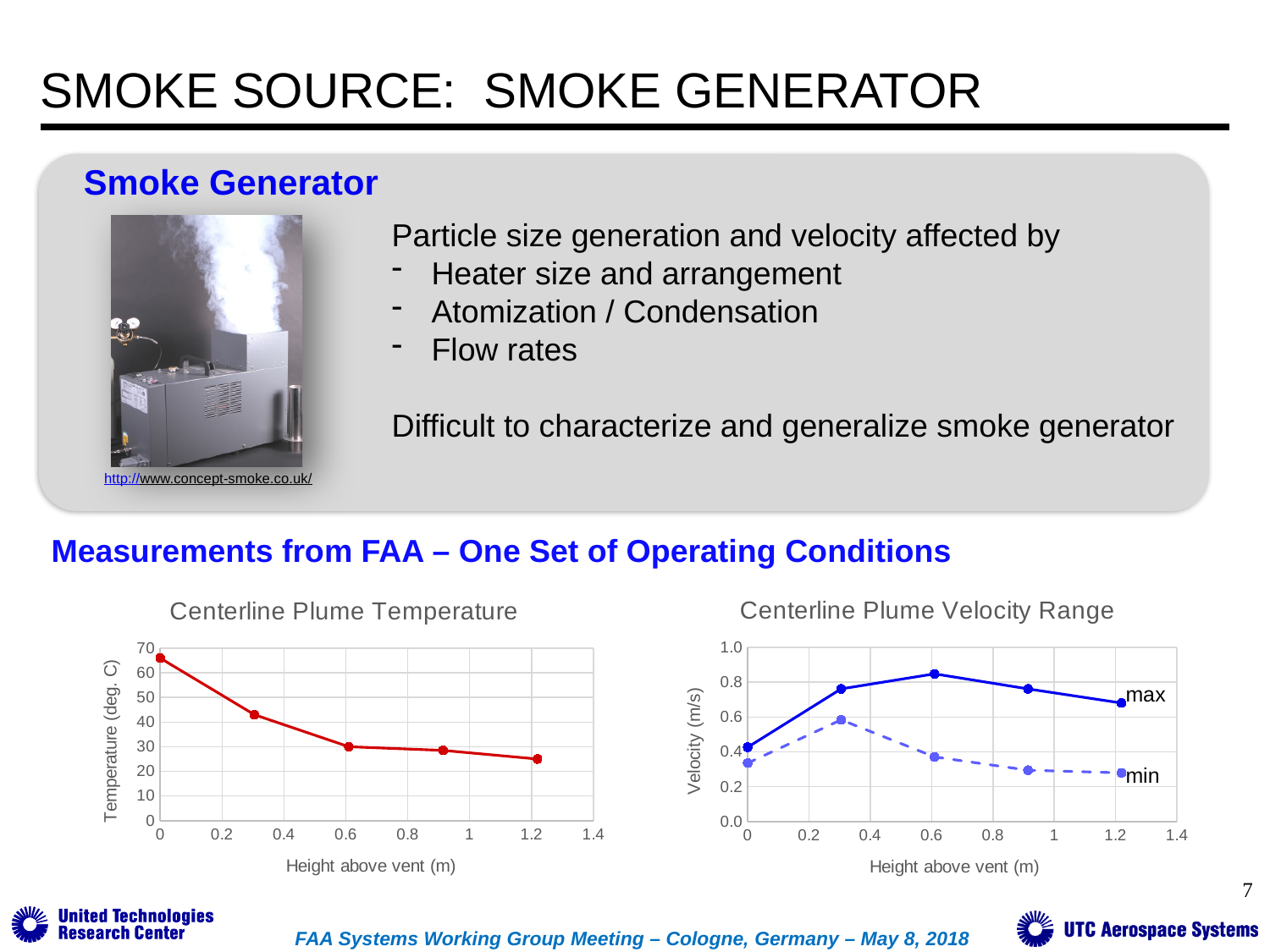
In the Centerline Plume Velocity Range chart, is the max velocity at height 0.6 m greater or less than 0.8? greater In the Centerline Plume Temperature chart, what is the label of the y axis? Temperature (deg. C) In the Centerline Plume Temperature chart, at which height above vent is the temperature highest? 0 In the Centerline Plume Temperature chart, is the temperature at height 1.2 m greater or less than 30? less What kind of chart is the Centerline Plume Temperature chart? line chart In the Centerline Plume Temperature chart, is the temperature at height 0 m greater or less than 60? greater In the Centerline Plume Velocity Range chart, how many series are plotted? 2 In the Centerline Plume Temperature chart, how many data points are plotted? 5 In the Centerline Plume Velocity Range chart, at which height above vent is the max velocity highest? 0.6 In the Centerline Plume Velocity Range chart, which series is drawn with a dashed line? min In the Centerline Plume Velocity Range chart, at which height above vent is the min velocity highest? 0.3 In the Centerline Plume Temperature chart, does the temperature rise or fall as height above vent increases? fall